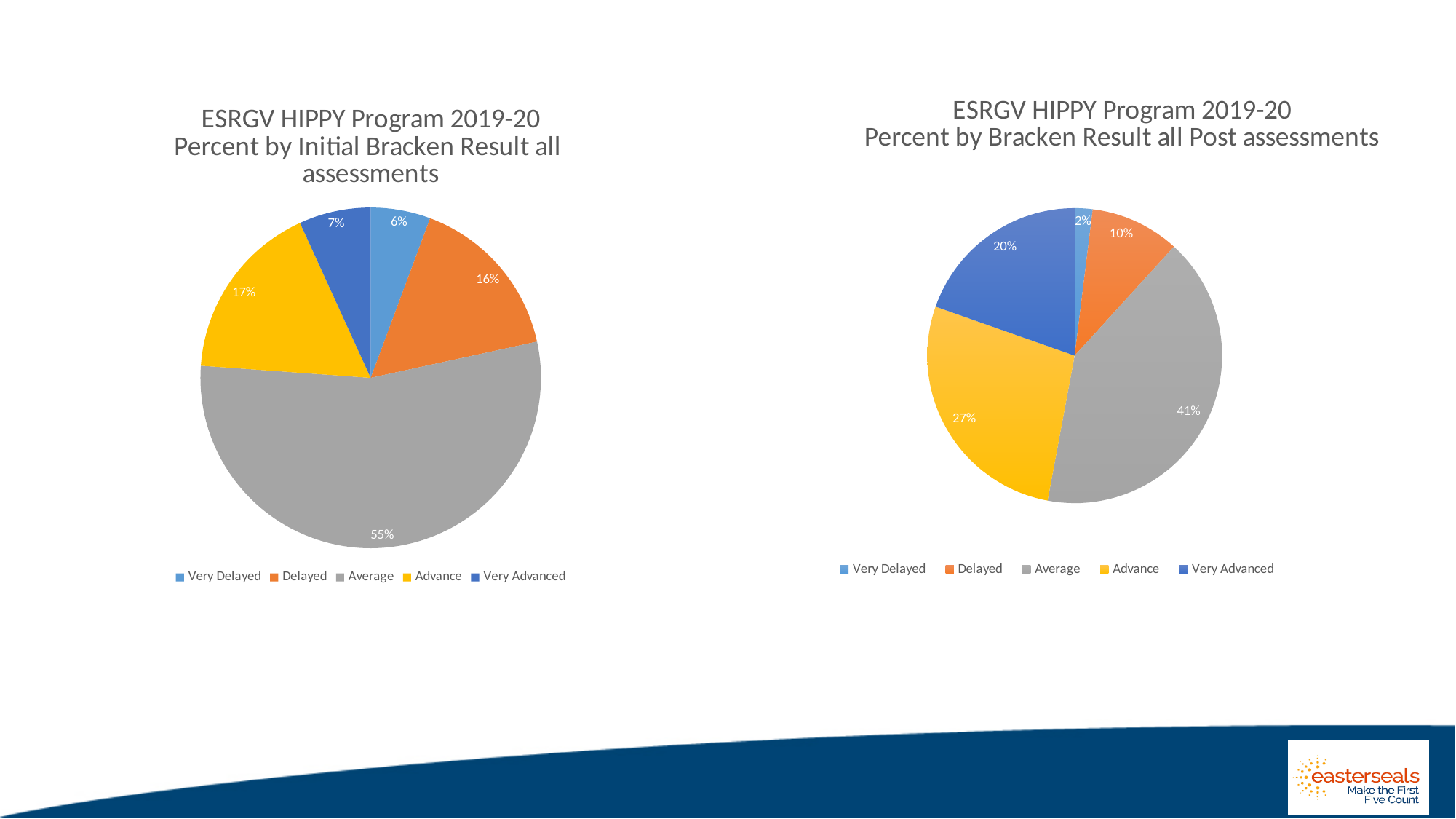
In the left chart (Initial Bracken Result), which category has the smallest slice? Very Delayed In the right chart (Post assessments), which category has the smallest slice? Very Delayed What is the title of the right chart? ESRGV HIPPY Program 2019-20 Percent by Bracken Result all Post assessments How many categories does the legend of the left chart list? 5 In the left chart (Initial Bracken Result), what percentage is shown for Very Delayed? 6% In the left chart (Initial Bracken Result), what percentage is shown for Average? 55% In the right chart (Post assessments), what percentage is shown for Very Advanced? 20% What type of chart is used on the right side of the slide? Pie chart In the right chart (Post assessments), which category has the largest slice? Average In the right chart (Post assessments), what percentage is shown for Advance? 27% In the right chart (Post assessments), is the Advance slice larger or smaller than the Very Advanced slice? larger In the left chart (Initial Bracken Result), what is the difference between the Average and Advance percentages? 38%